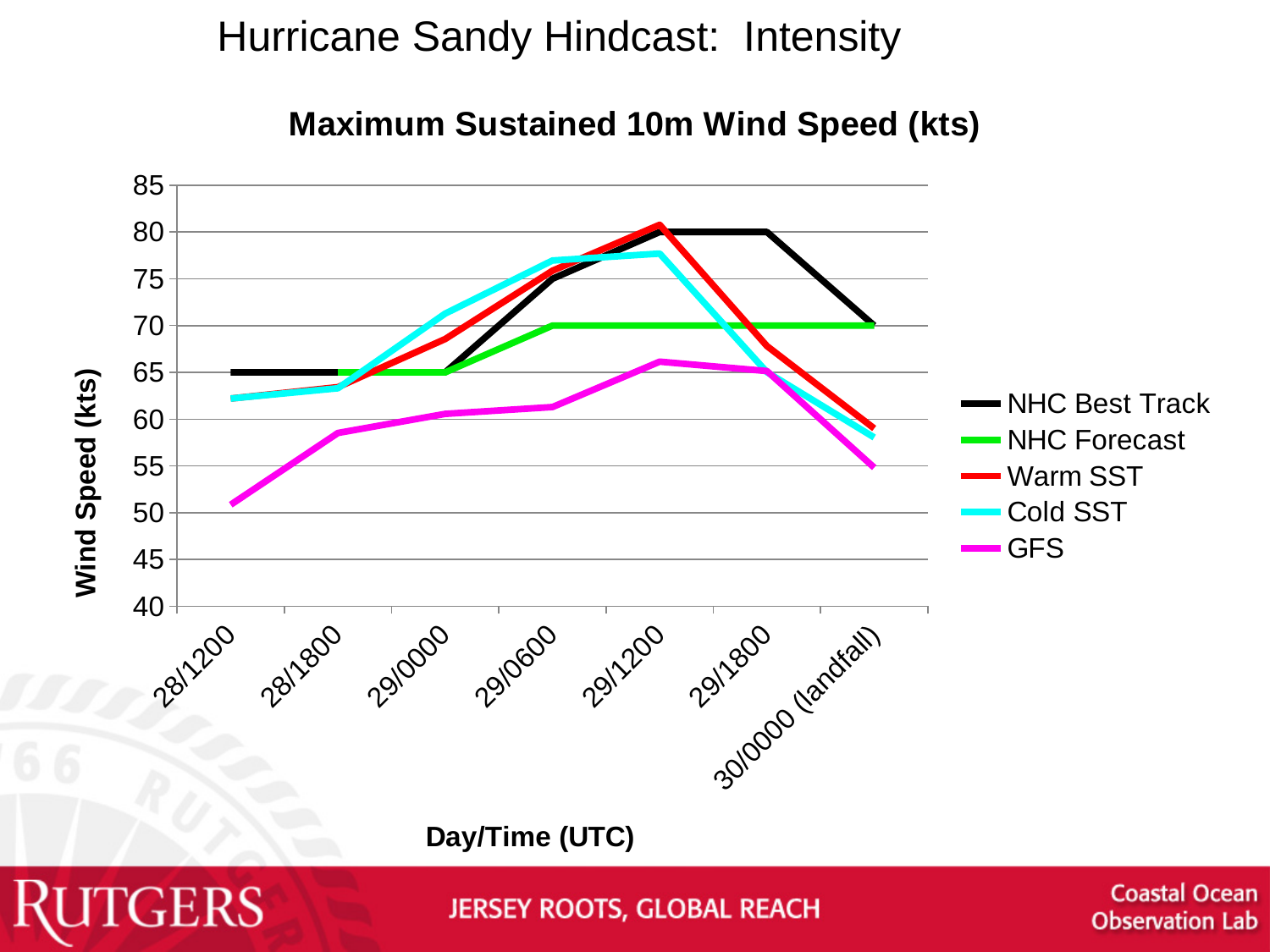
What type of chart is shown on the slide? line chart What is the NHC Best Track wind speed at 29/1200? 80 What is the difference between the NHC Best Track wind speed at 29/1200 and at 28/1200? 15 How many Day/Time categories are shown on the x axis? 7 Is the Warm SST wind speed at 29/1800 greater or less than 65? greater What is the title of the chart? Maximum Sustained 10m Wind Speed (kts) Which is larger at 29/1800: NHC Best Track or Cold SST? NHC Best Track What is the NHC Forecast wind speed at 29/0600? 70 How many series does the legend list? 5 Which series has the lowest wind speed at 28/1200? GFS What is the NHC Best Track wind speed at 30/0000 (landfall)? 70